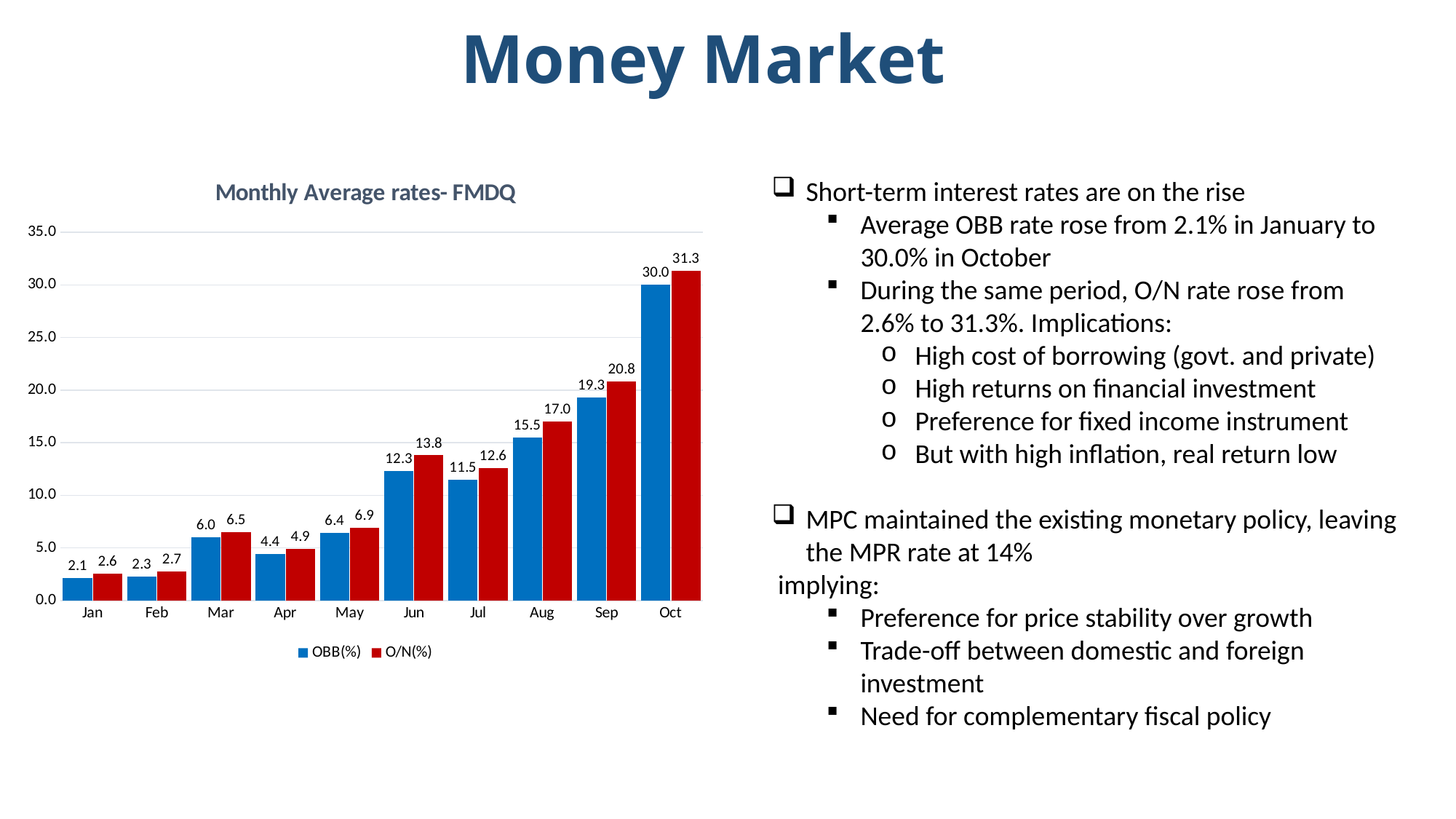
What is the title of the chart? Monthly Average rates- FMDQ What is the OBB(%) value for Jun? 12.3 What colour are the O/N(%) bars? red Which month has the lowest OBB(%) value? Jan Which is larger, the OBB(%) value for Jul or the OBB(%) value for Jun? Jun What is the O/N(%) value for Sep? 20.8 What is the difference between the O/N(%) and OBB(%) values for Oct? 1.3 How many series does the legend list? 2 How many months are shown on the x axis? 10 Which month has the highest O/N(%) value? Oct What kind of chart is shown on the slide? bar chart Do the OBB(%) values generally rise or fall from Jan to Oct? rise